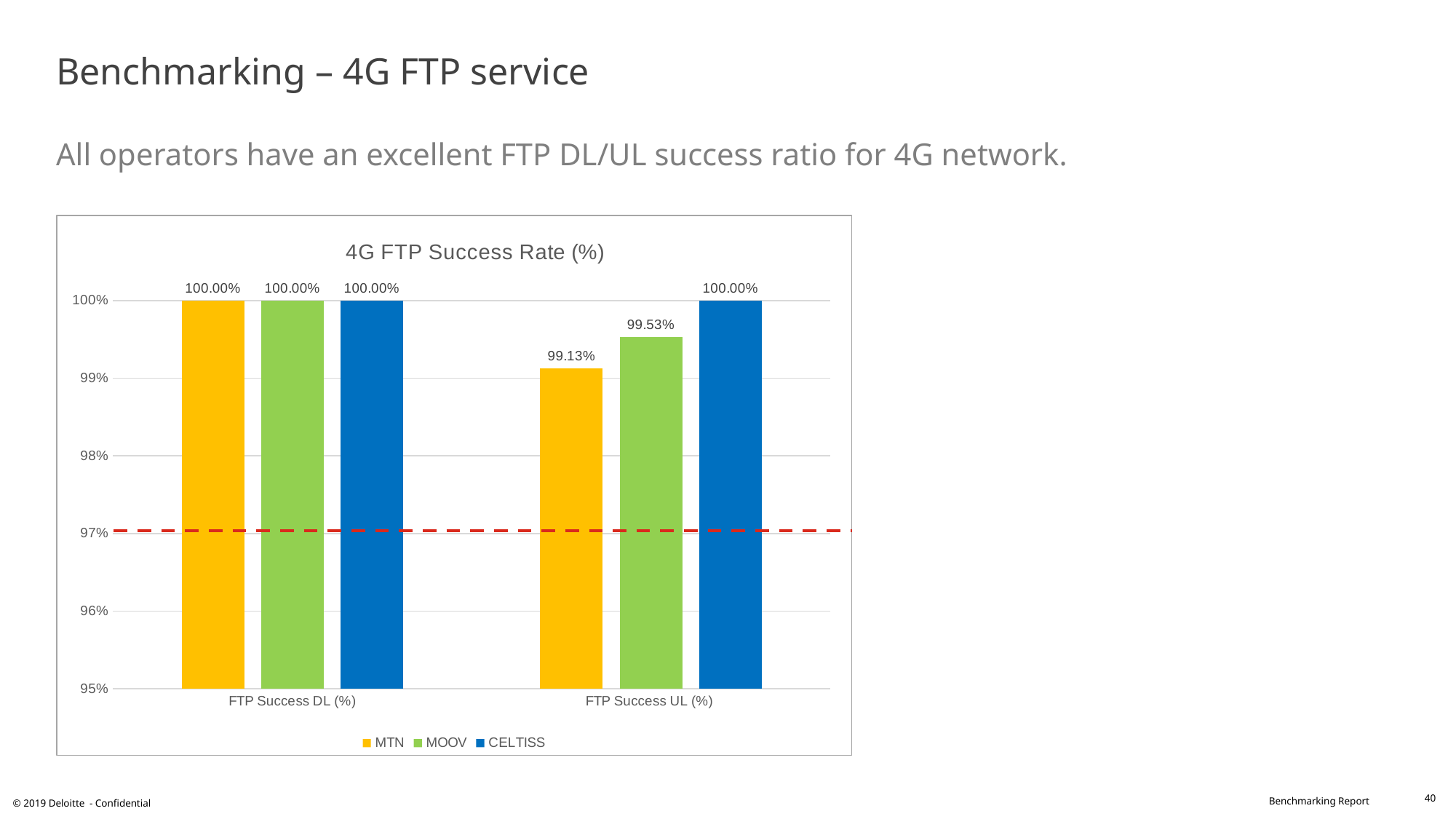
What is the value for MOOV in the FTP Success UL (%) category? 99.53% Which operator has the highest value in the FTP Success UL (%) category? CELTISS What is the value for MTN in the FTP Success UL (%) category? 99.13% What is the value for CELTISS in the FTP Success DL (%) category? 100.00% What is the title of the chart? 4G FTP Success Rate (%) How many categories are shown on the x axis? 2 Which operator has the lowest value in the FTP Success UL (%) category? MTN What is the difference between the MOOV and MTN values in the FTP Success UL (%) category? 0.40% How many series does the legend list? 3 Is the value for MTN in FTP Success UL (%) greater or less than 97%? greater Which is larger: MOOV's FTP Success UL (%) value or MTN's FTP Success UL (%) value? MOOV What is the difference between the CELTISS and MTN values in the FTP Success UL (%) category? 0.87%